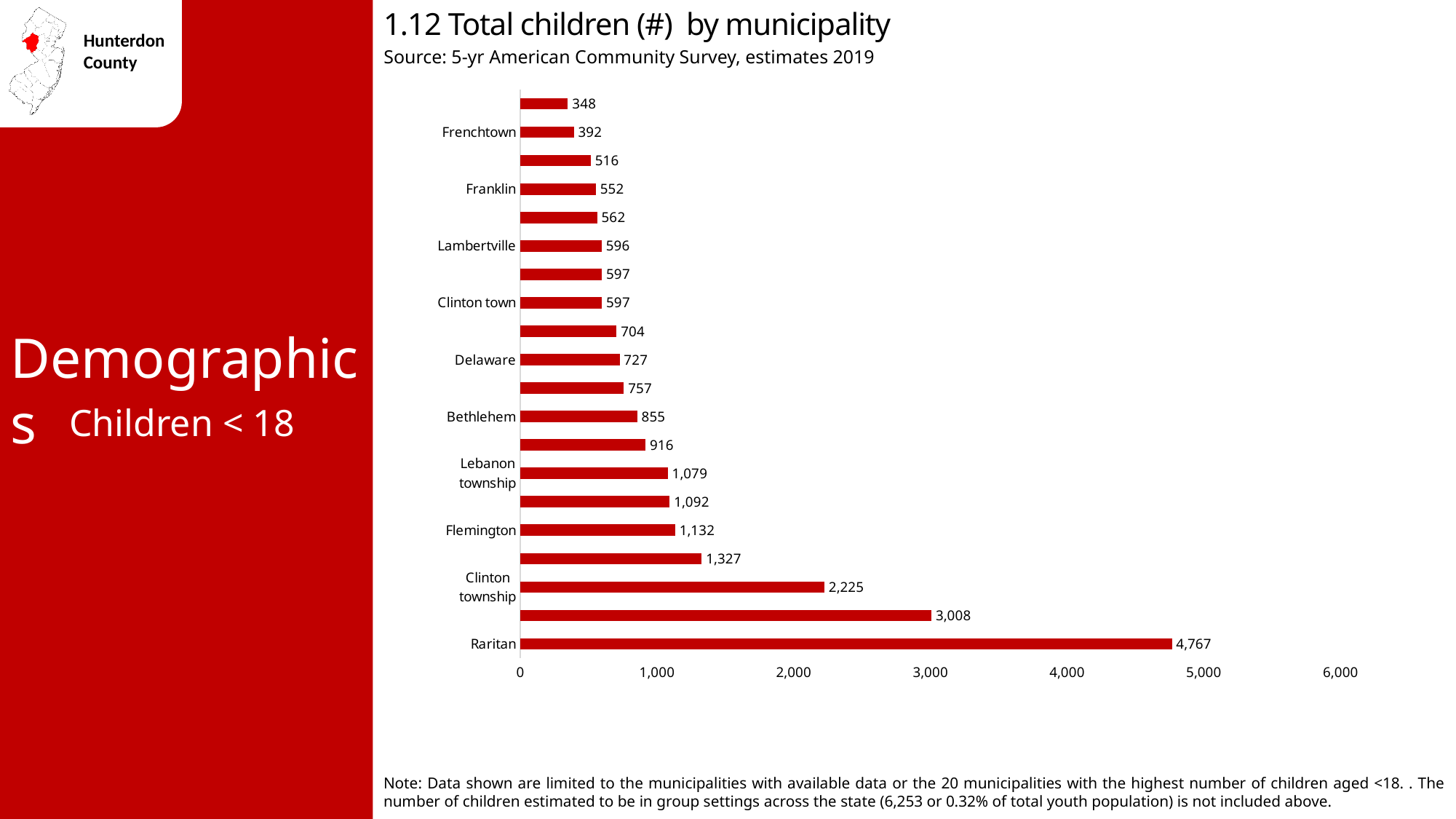
What is the difference between the values for Raritan and Clinton township? 2,542 What is the smallest value shown on the chart? 348 What is the value for Flemington? 1,132 Which has more children, Delaware or Bethlehem? Bethlehem Which municipality has the highest number of children? Raritan What is the value for Clinton township? 2,225 What is the difference between the values for Flemington and Lebanon township? 53 How many children are shown for Raritan? 4,767 How many bars are plotted on the chart? 20 What is the value for Frenchtown? 392 What type of chart is shown on the slide? bar chart Is the value for Lebanon township greater or less than 1,000? greater